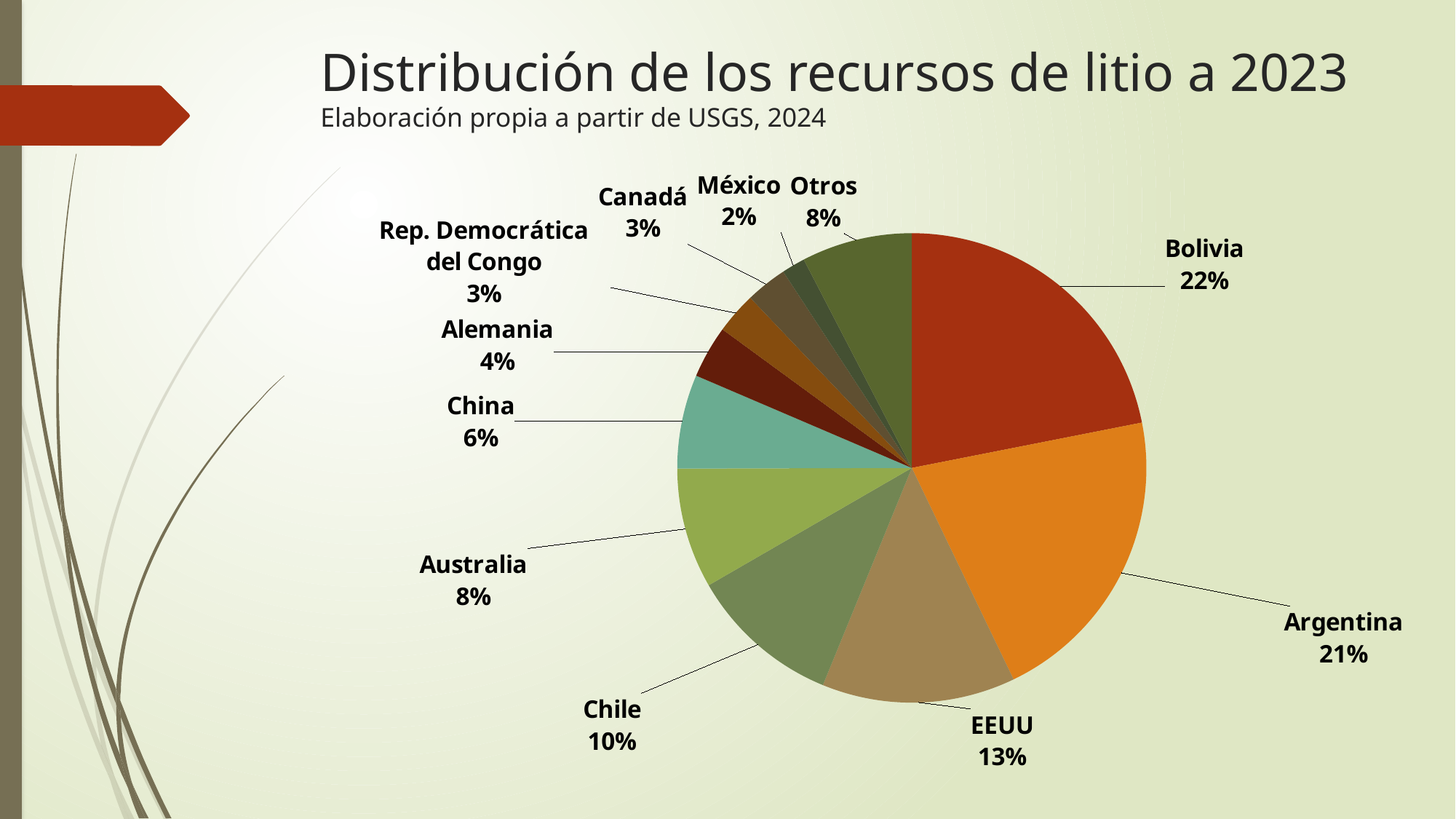
Which country has the largest slice of the pie chart? Bolivia What percentage is shown for Chile? 10% Which is larger, the share for Australia or the share for Alemania? Australia What is the title of the chart on the slide? Distribución de los recursos de litio a 2023 What kind of chart is shown on the slide? Pie chart What share of lithium resources does Bolivia hold according to the pie chart? 22% What percentage is shown for EEUU? 13% What percentage is shown for Rep. Democrática del Congo? 3% What is the difference in percentage points between Chile and China? 4 Which category has the smallest slice of the pie chart? México How many slices does the pie chart have? 11 What percentage is shown for Argentina? 21%